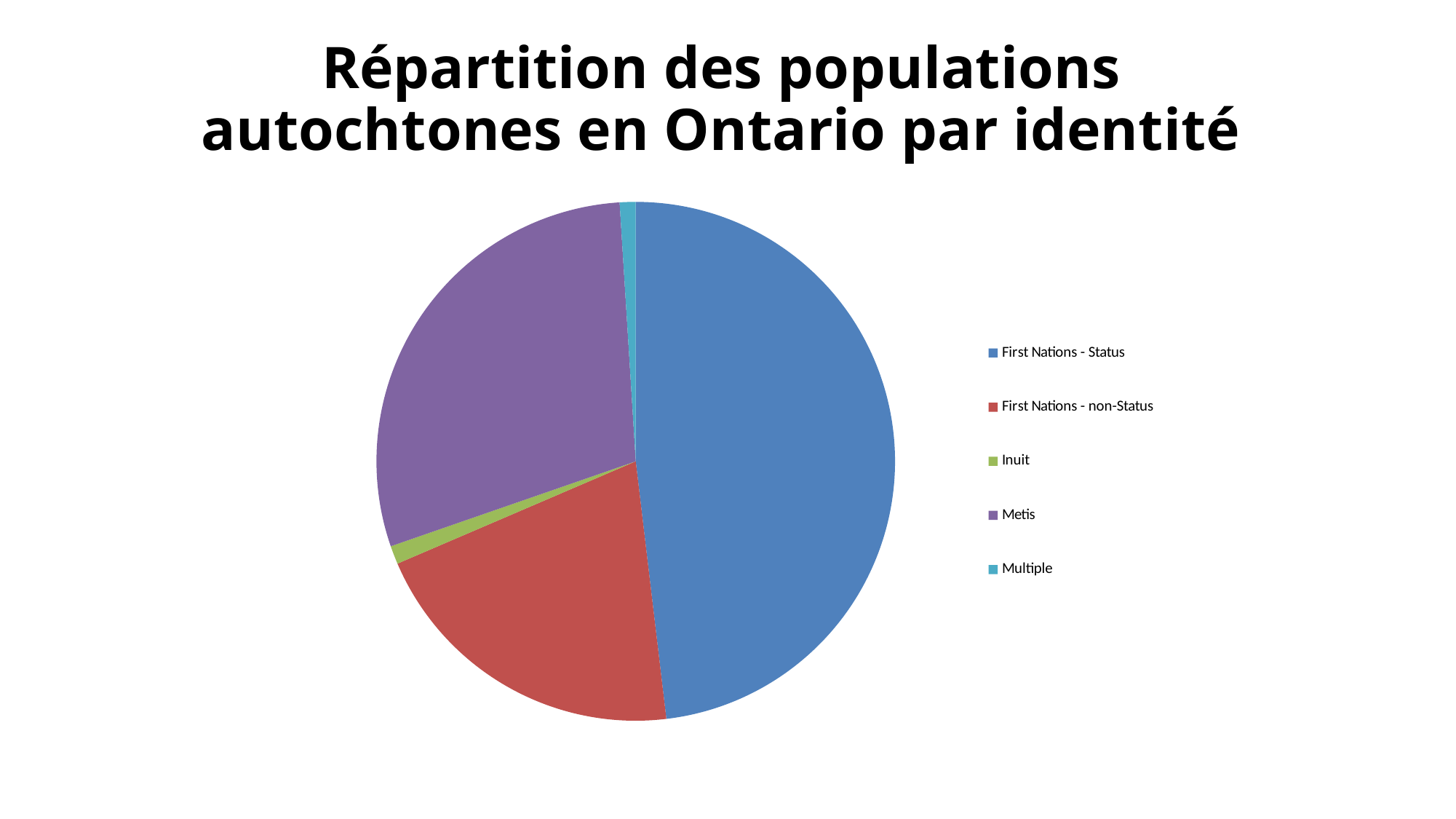
Which category has the largest slice of the pie? First Nations - Status Which slice is larger, Metis or First Nations - non-Status? Metis What kind of chart is shown on the slide? Pie chart Which slice is larger, First Nations - Status or Inuit? First Nations - Status How many categories (slices) does the pie chart have? 5 Which slice is larger, First Nations - Status or Metis? First Nations - Status What is the title of the chart? Répartition des populations autochtones en Ontario par identité What colour is the Metis slice in the pie chart? Purple